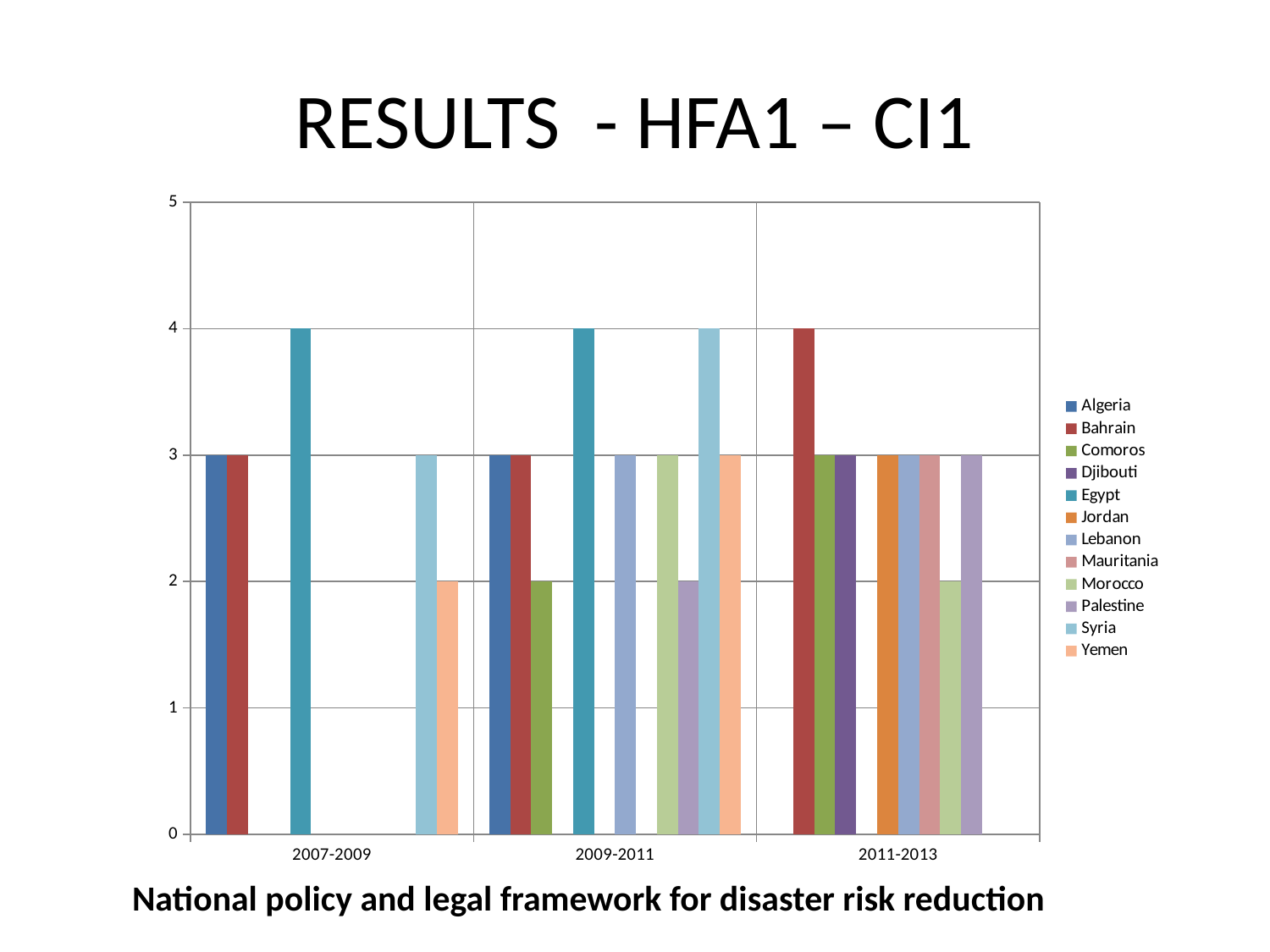
What is the value for Egypt in 2007-2009? 4 What type of chart is shown on the slide? bar chart What is the difference between Egypt and Yemen in 2007-2009? 2 What is the value for Morocco in 2011-2013? 2 Which country has the highest value in 2011-2013? Bahrain What is the value for Syria in 2009-2011? 4 How many series does the legend list? 12 What is the value for Yemen in 2007-2009? 2 How many period categories are shown on the x axis? 3 Which is larger in 2009-2011, the value for Comoros or the value for Lebanon? Lebanon What is the value for Bahrain in 2011-2013? 4